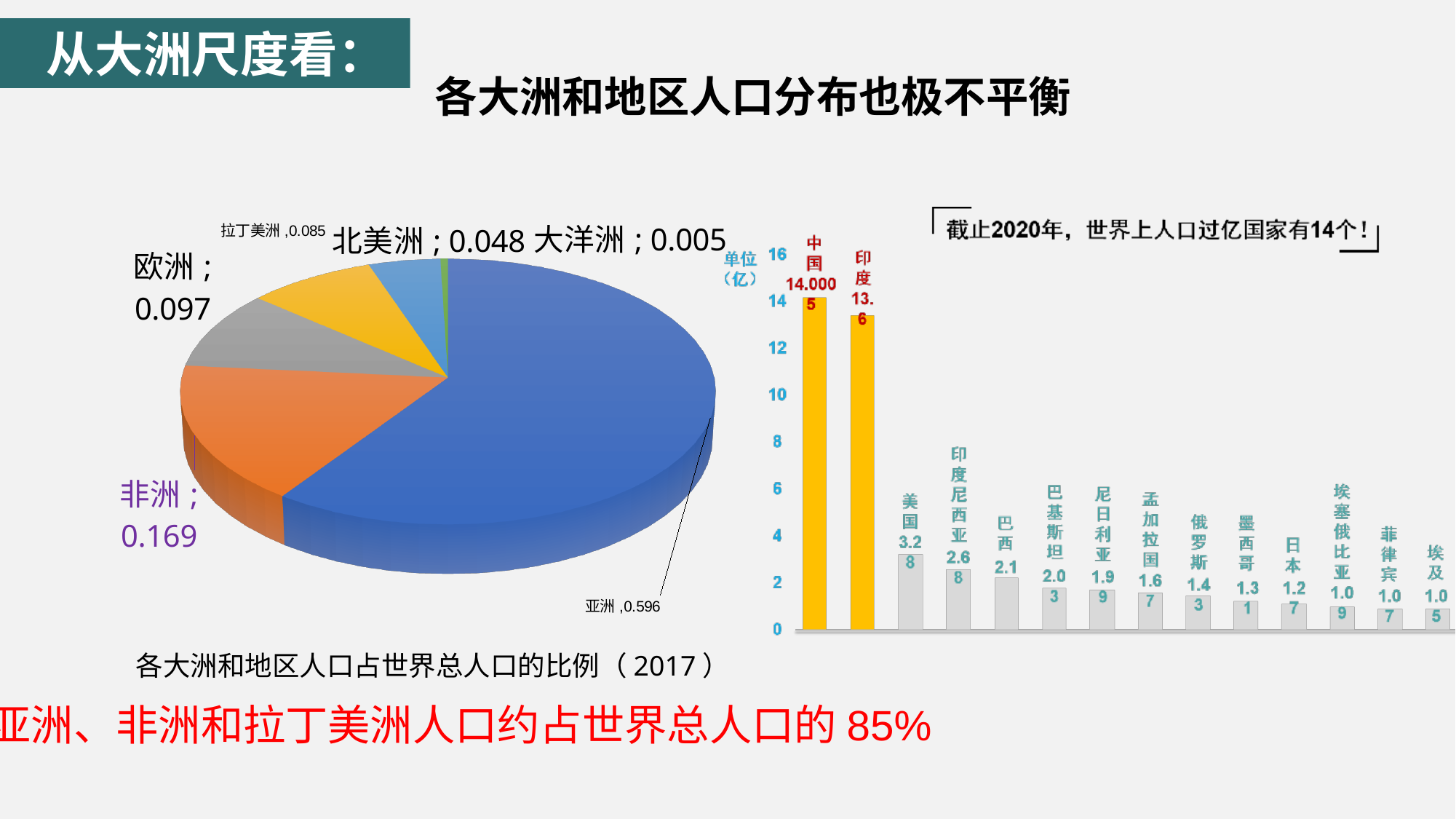
In the pie chart on the left, which region has the largest share? 亚洲 In the pie chart on the left, which is larger, the value for 欧洲 or the value for 拉丁美洲? 欧洲 In the bar chart on the right, which country has the highest value? 中国 What kind of chart is the chart on the right of the slide showing countries with populations over 100 million? bar chart In the pie chart on the left, what is the value for 亚洲? 0.596 In the pie chart on the left, which region has the smallest share? 大洋洲 What kind of chart is the chart on the left of the slide (各大洲和地区人口占世界总人口的比例)? pie chart In the pie chart on the left, what is the difference between the values for 亚洲 and 非洲? 0.427 How many countries are shown in the bar chart on the right? 14 In the bar chart on the right, what is the value for 巴西? 2.1 In the pie chart on the left, what is the value for 非洲? 0.169 How many regions are shown in the pie chart on the left? 6